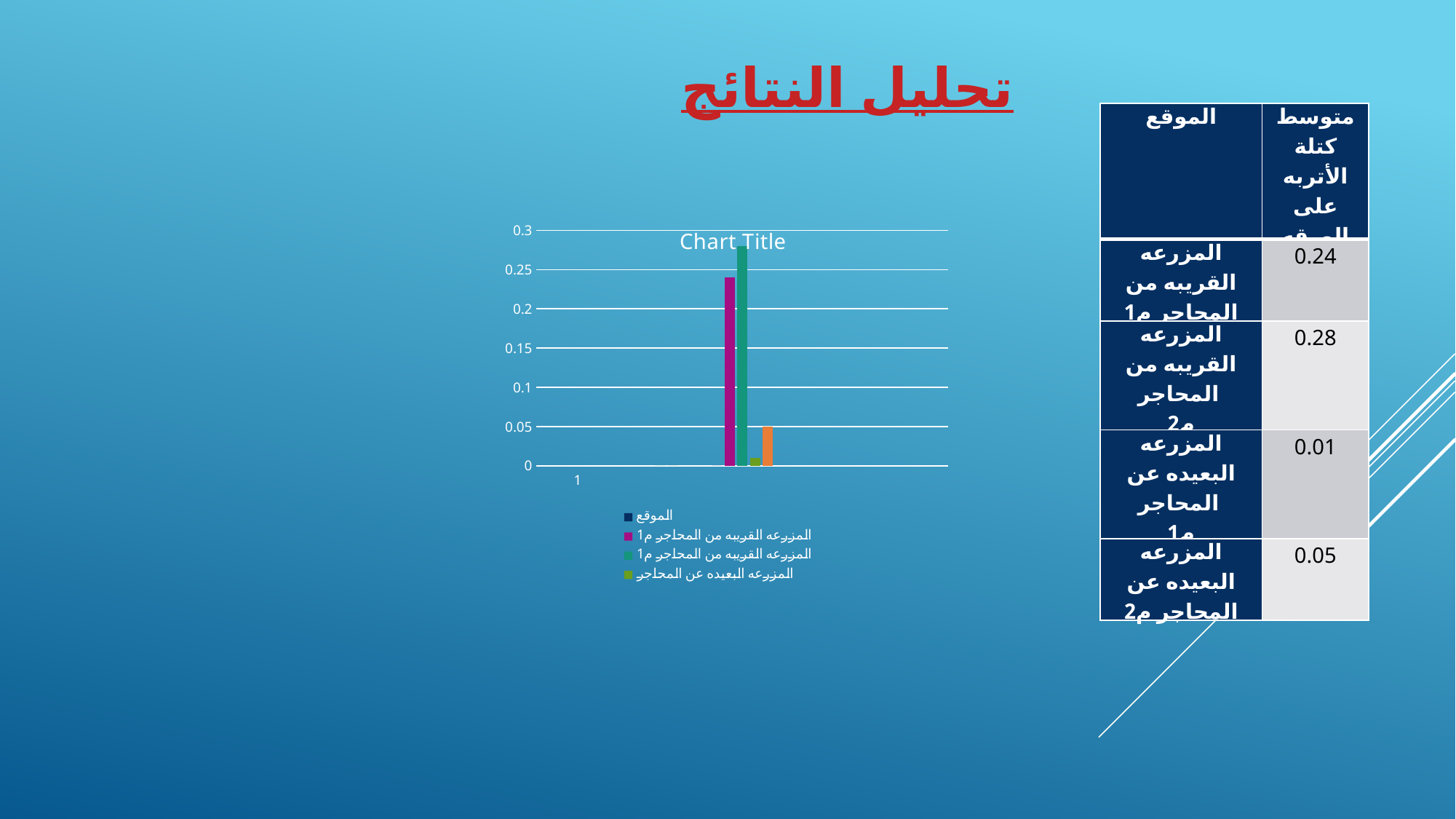
Is the value of the orange bar greater or less than 0.1? less What is the title shown on the chart? Chart Title Is the value of the green bar greater or less than 0.25? greater Which is larger, the magenta bar or the orange bar? the magenta bar How many entries does the chart's legend list? 4 What is the highest tick value shown on the chart's y axis? 0.3 How many categories are shown on the chart's x axis? 1 Is the value of the olive green bar greater or less than 0.05? less Which coloured bar in the chart is the shortest? the olive green bar What kind of chart is shown on the slide? bar chart Which coloured bar in the chart is the tallest? the green bar